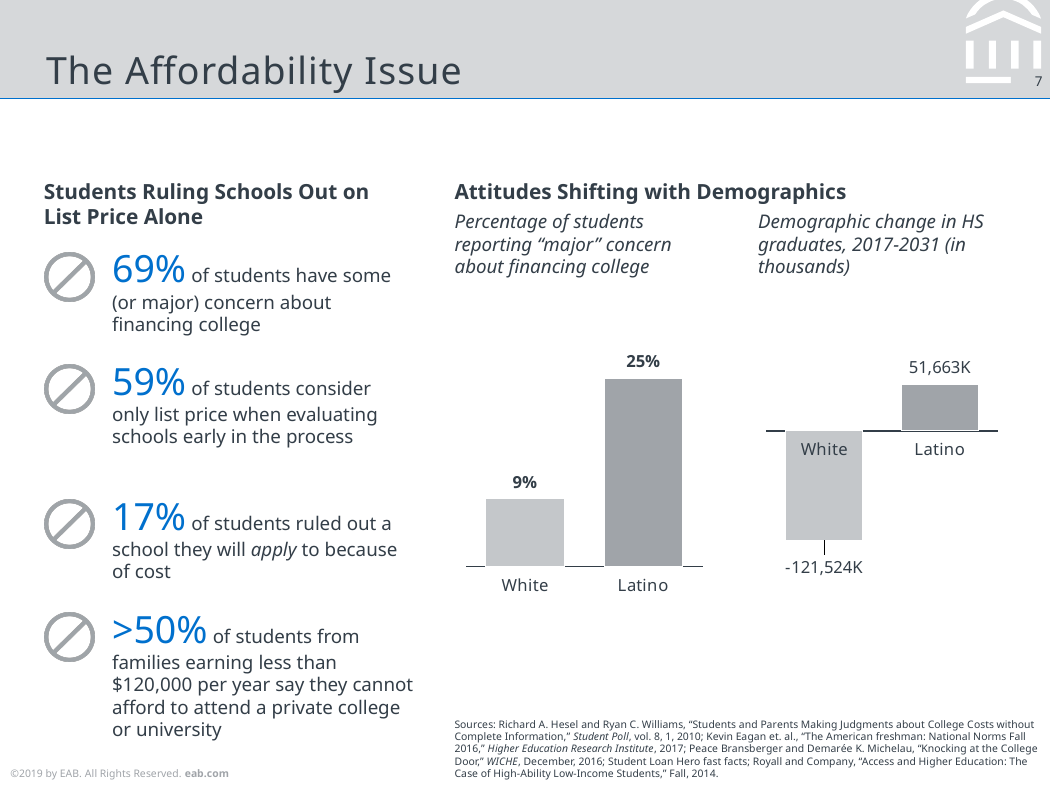
In the chart of the percentage of students reporting "major" concern about financing college, which group has the higher value? Latino In the chart of the percentage of students reporting "major" concern about financing college, how many categories are shown? 2 In the chart of demographic change in HS graduates, 2017-2031, what is the value for White? -121,524K In the chart of the percentage of students reporting "major" concern about financing college, what is the difference between the Latino and White values? 16 percentage points What kind of chart is the one showing the percentage of students reporting "major" concern about financing college? Bar chart In the chart of the percentage of students reporting "major" concern about financing college, what is the value for Latino students? 25% In the chart of demographic change in HS graduates, 2017-2031, is the value for White greater or less than 0? less In the chart of demographic change in HS graduates, 2017-2031, how many categories are shown? 2 In the chart of the percentage of students reporting "major" concern about financing college, what is the value for White students? 9% What is the heading above the two charts on the right side of the slide? Attitudes Shifting with Demographics In the chart of demographic change in HS graduates, 2017-2031, which group has the lower value? White In the chart of demographic change in HS graduates, 2017-2031, what is the value for Latino? 51,663K